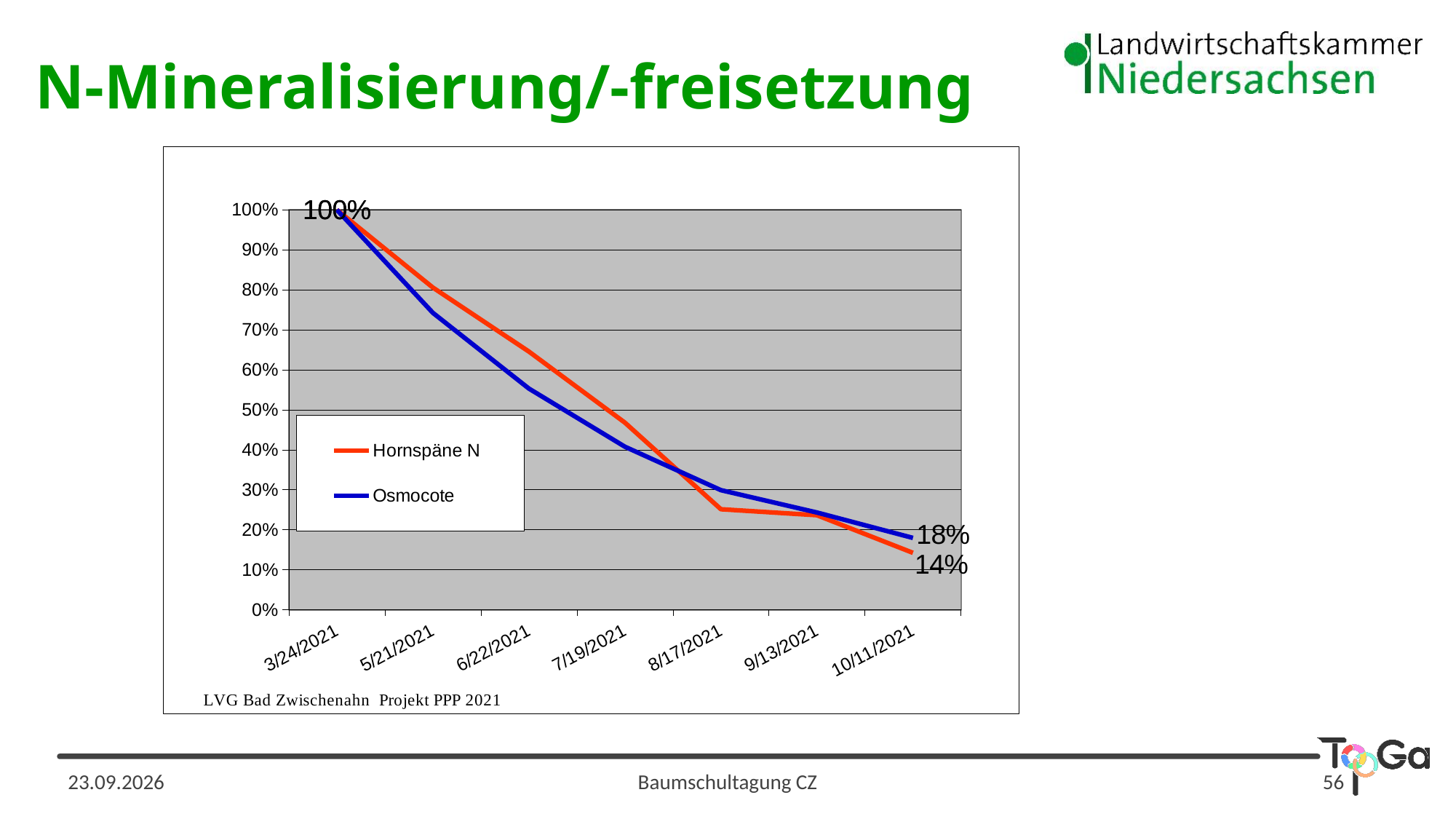
How many series does the legend list? 2 Do the values rise or fall along the x axis from 3/24/2021 to 10/11/2021? fall Is the value for Hornspäne N on 8/17/2021 greater or less than 30%? less What is the difference between the Osmocote and Hornspäne N values on 10/11/2021? 4 percentage points Is the value for Osmocote on 5/21/2021 greater or less than 80%? less What type of chart is shown on the slide? line chart On 10/11/2021, which series has the higher value, Hornspäne N or Osmocote? Osmocote Which series is drawn in blue? Osmocote What is the value for Hornspäne N on 10/11/2021? 14% How many dates are shown on the x axis? 7 What value do both series start at on 3/24/2021? 100% What is the value for Osmocote on 10/11/2021? 18%